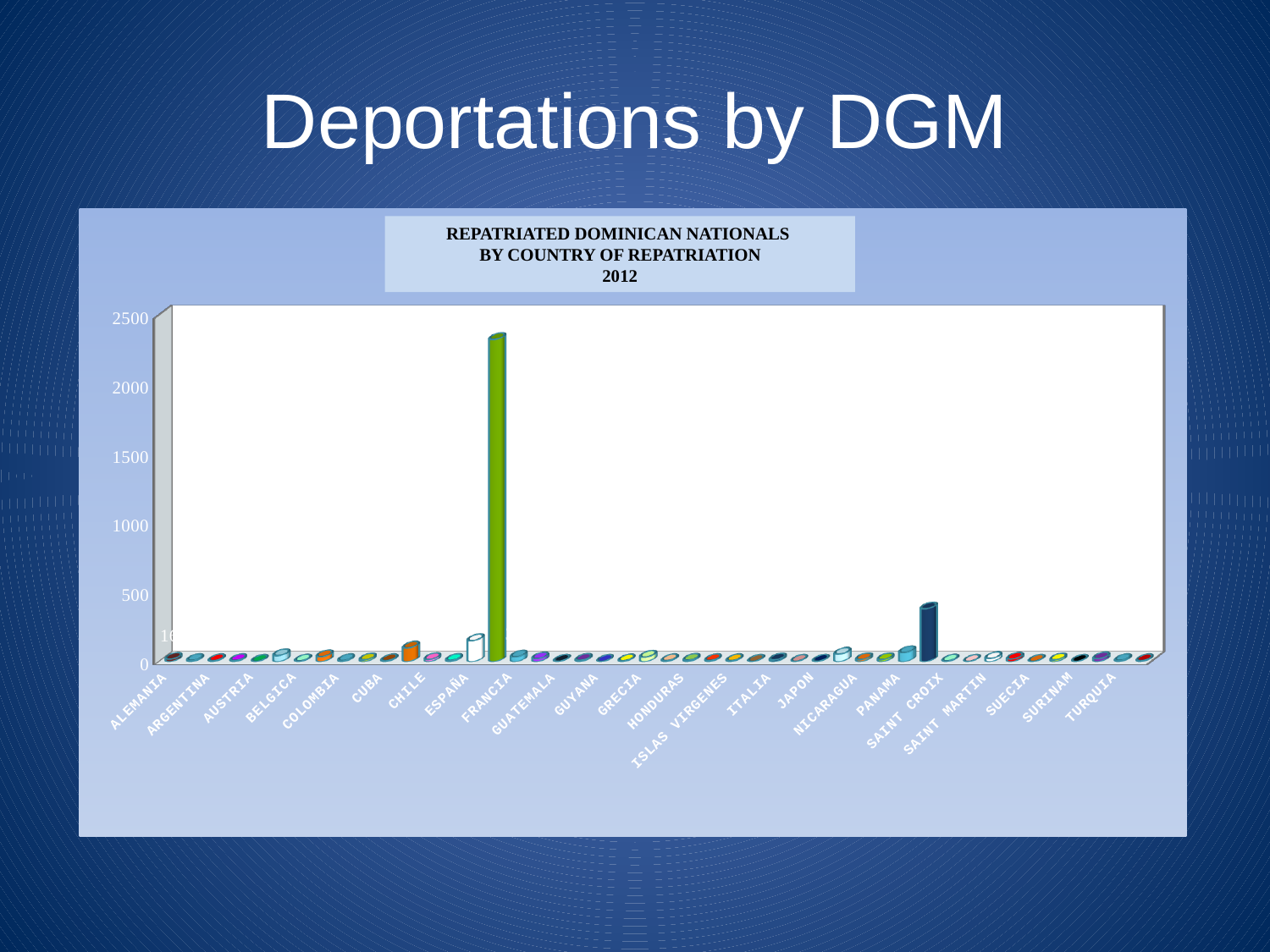
Is the value of the tallest bar greater or less than 2000? greater Is the value for CHILE greater or less than 500? less What is the title of the chart? REPATRIATED DOMINICAN NATIONALS BY COUNTRY OF REPATRIATION 2012 Is the value of the second tallest bar (the dark blue one) greater or less than 500? less What kind of chart is shown on the slide? bar chart Which country label appears first on the horizontal axis? ALEMANIA What year does the chart title refer to? 2012 How many country labels are printed along the horizontal axis? 23 Which country label appears last on the horizontal axis? TURQUIA What is the highest value shown on the vertical axis? 2500